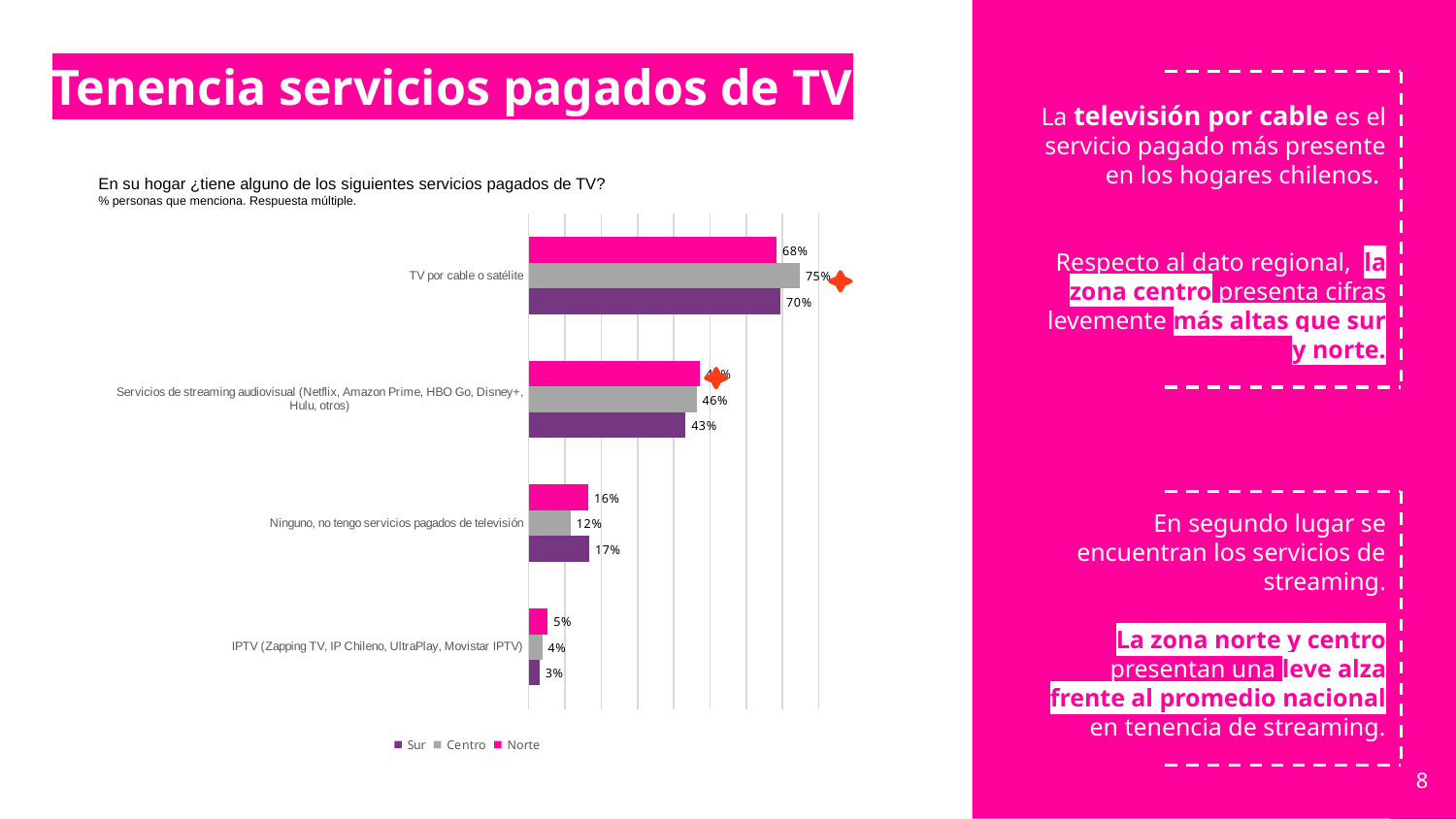
Which category has the highest value for Centro? TV por cable o satélite What is the value for Centro in the category 'TV por cable o satélite'? 75% What is the value for Centro in the category 'Servicios de streaming audiovisual'? 46% How many categories are shown on the chart? 4 What kind of chart is shown on the slide? Bar chart Which is larger for 'Ninguno, no tengo servicios pagados de televisión': the Norte value or the Centro value? Norte Which category has the lowest value for Sur? IPTV (Zapping TV, IP Chileno, UltraPlay, Movistar IPTV) How many series does the legend list? 3 What is the difference between the Centro and Norte values for 'TV por cable o satélite'? 7% What is the value for Norte in the category 'TV por cable o satélite'? 68% What is the value for Sur in the category 'Ninguno, no tengo servicios pagados de televisión'? 17% What is the value for Sur in the category 'TV por cable o satélite'? 70%